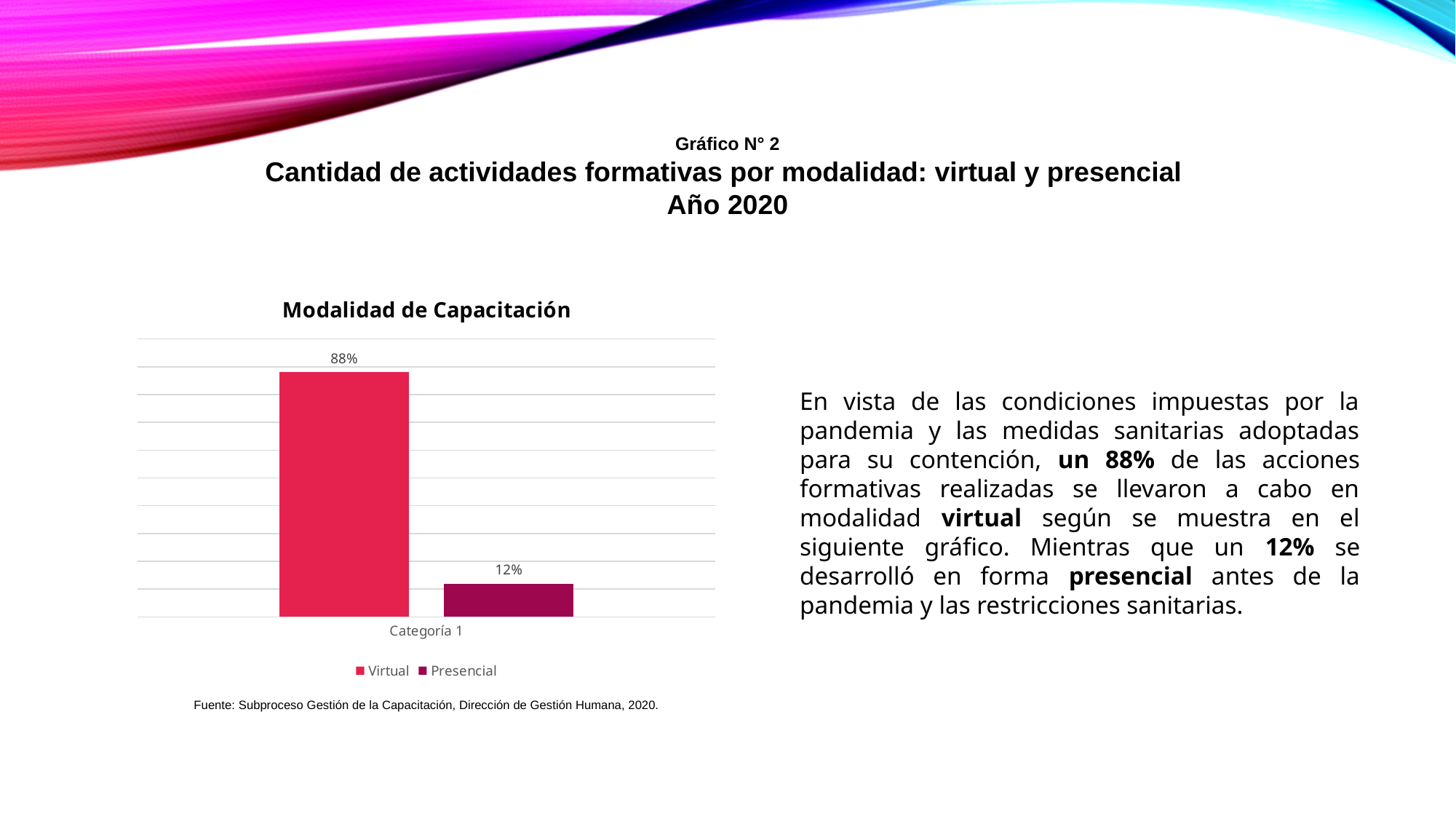
What kind of chart is shown on the slide? Bar chart Which is larger, the value for Virtual or the value for Presencial? Virtual Which series has the highest value in the chart? Virtual What is the value for Presencial in the Modalidad de Capacitación chart? 12% How many categories are shown on the x axis of the chart? 1 Which series has the lowest value in the chart? Presencial How many series does the legend list? 2 What is the title of the chart? Modalidad de Capacitación What is the difference between the Virtual and Presencial values? 76% What is the value for Virtual in the Modalidad de Capacitación chart? 88% What is the total of the Virtual and Presencial values? 100% What is the category label shown on the x axis of the chart? Categoría 1